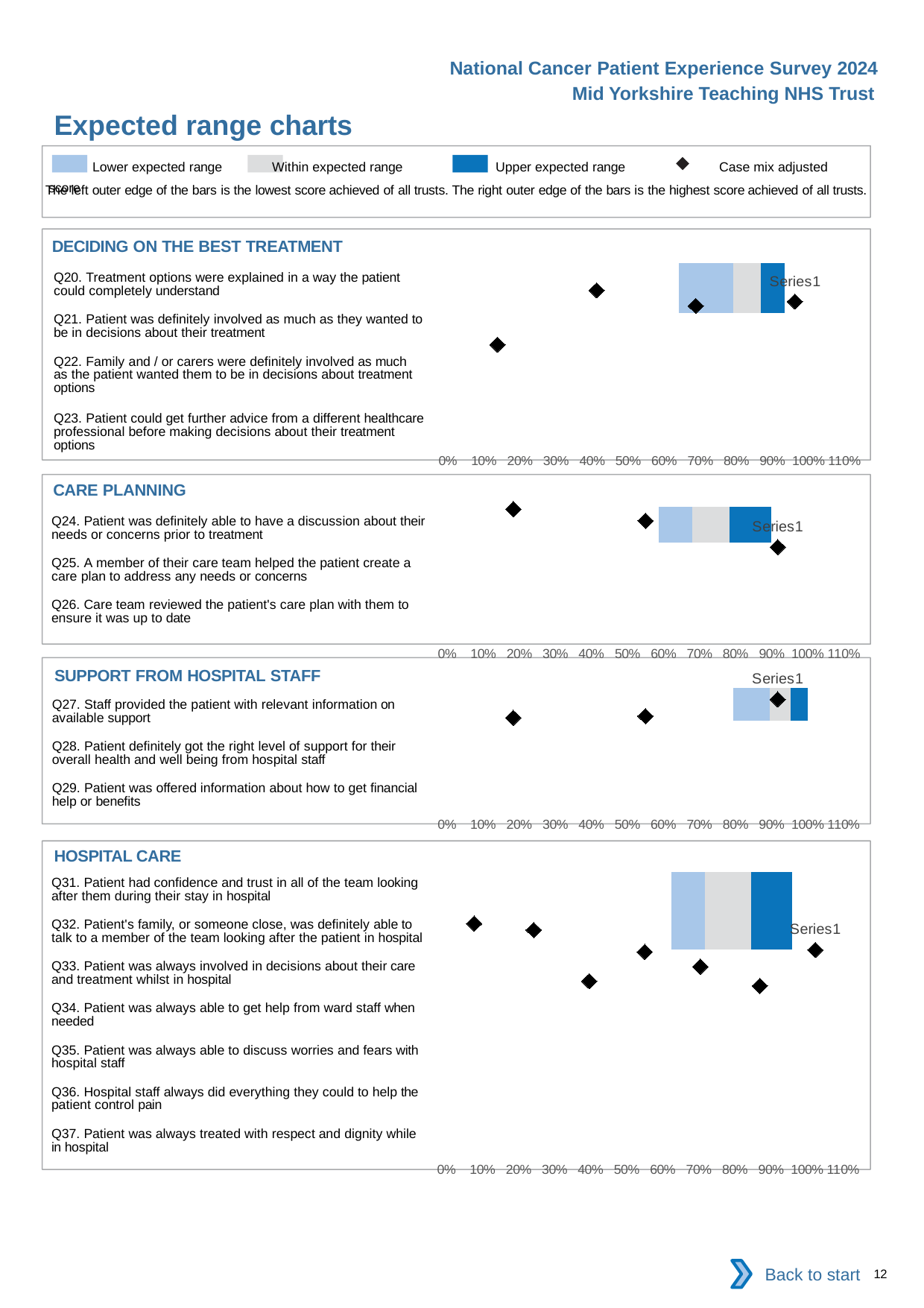
In the HOSPITAL CARE chart, is the left edge of the expected range bar greater or less than 50%? greater In the SUPPORT FROM HOSPITAL STAFF chart, is the left edge of the expected range bar greater or less than 70%? greater According to the legend, what does the diamond marker represent? Case mix adjusted score How many questions are listed in the DECIDING ON THE BEST TREATMENT chart? 4 What is the lowest value labelled on the x axis of the CARE PLANNING chart? 0% What is the highest value labelled on the x axis of the HOSPITAL CARE chart? 110% According to the legend, what does the dark blue colour represent? Upper expected range What kind of chart is used in the DECIDING ON THE BEST TREATMENT section? bar chart How many questions are listed in the HOSPITAL CARE chart? 7 How many separate charts are shown on the slide? 4